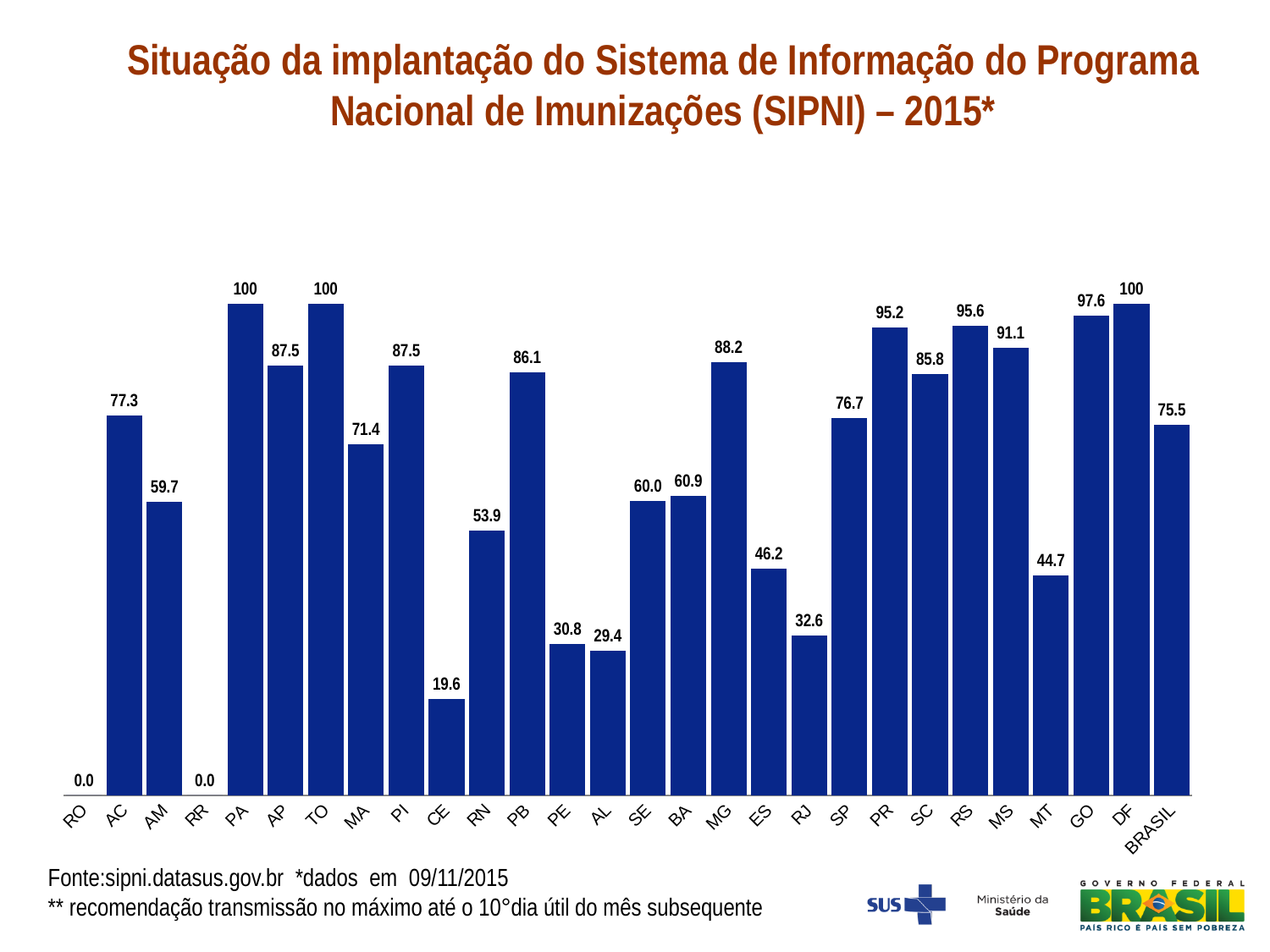
What is the difference between the values for DF and MT? 55.3 Which has the larger value, PE or AL? PE What kind of chart is shown on the slide? Bar chart How many categories have a value of 100? 3 What year does the chart title refer to? 2015 Which has the larger value, PR or RS? RS How many categories are shown on the x axis? 28 What is the value shown for CE? 19.6 What is the value shown for MG? 88.2 Which categories have a value of 0.0? RO and RR What is the value shown for BRASIL? 75.5 What is the difference between the values for GO and SP? 20.9